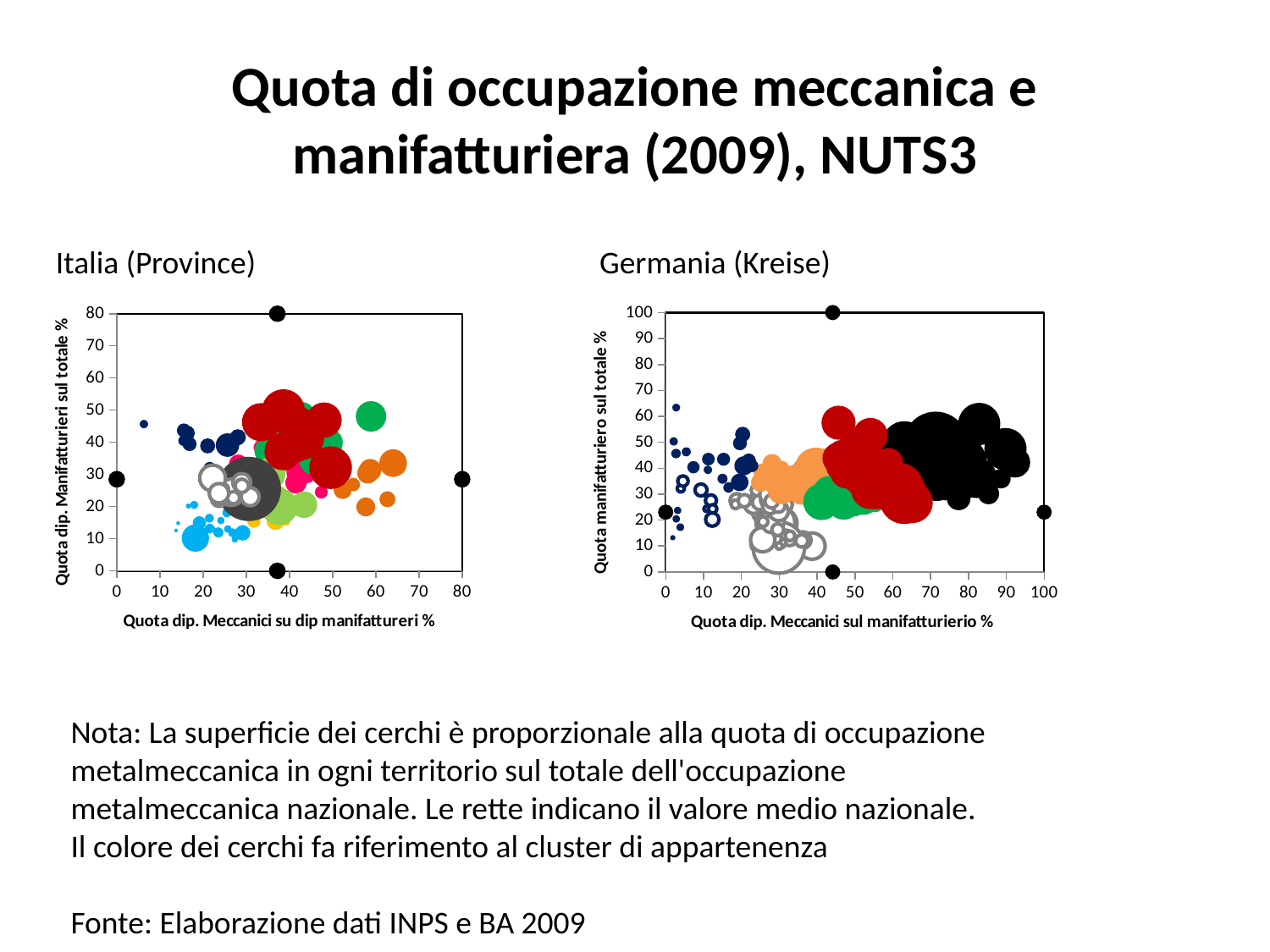
What is the maximum value shown on the x axis of the Italia (Province) chart? 80 In the Germania (Kreise) chart, are the dark blue bubbles located at x values greater or less than 30? less Which chart has the larger maximum value on its x axis, Italia (Province) or Germania (Kreise)? Germania (Kreise) How many charts are shown on the slide? 2 What kind of chart is the Germania (Kreise) chart? Bubble chart What kind of chart is the Italia (Province) chart? Bubble chart In the Italia (Province) chart, are the light blue bubbles located at y values greater or less than 20? less In the Germania (Kreise) chart, are the grey hollow bubbles located at y values greater or less than 40? less What is the maximum value shown on the y axis of the Germania (Kreise) chart? 100